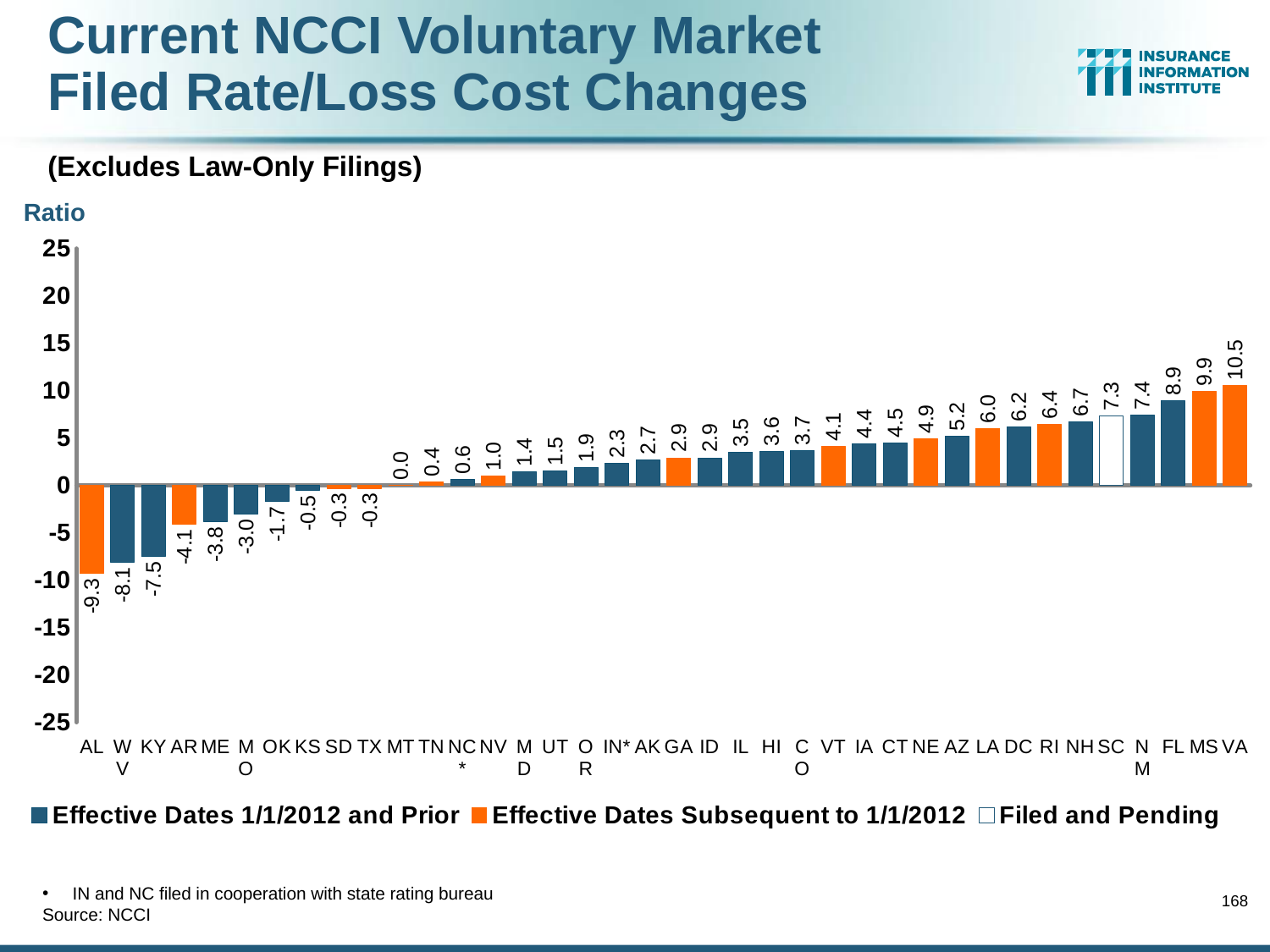
What is the value for AL? -9.3 What is the value for VA? 10.5 Do the values rise or fall from left to right along the x axis? Rise Which state has the lowest value? AL Which legend series does the SC bar belong to? Filed and Pending What is the value for SC? 7.3 Which state has the highest value? VA What is the difference between the values for VA and AL? 19.8 How many states are shown on the x axis? 38 Which is larger, the value for MS or the value for FL? MS How many series does the legend list? 3 What kind of chart is this? Bar chart